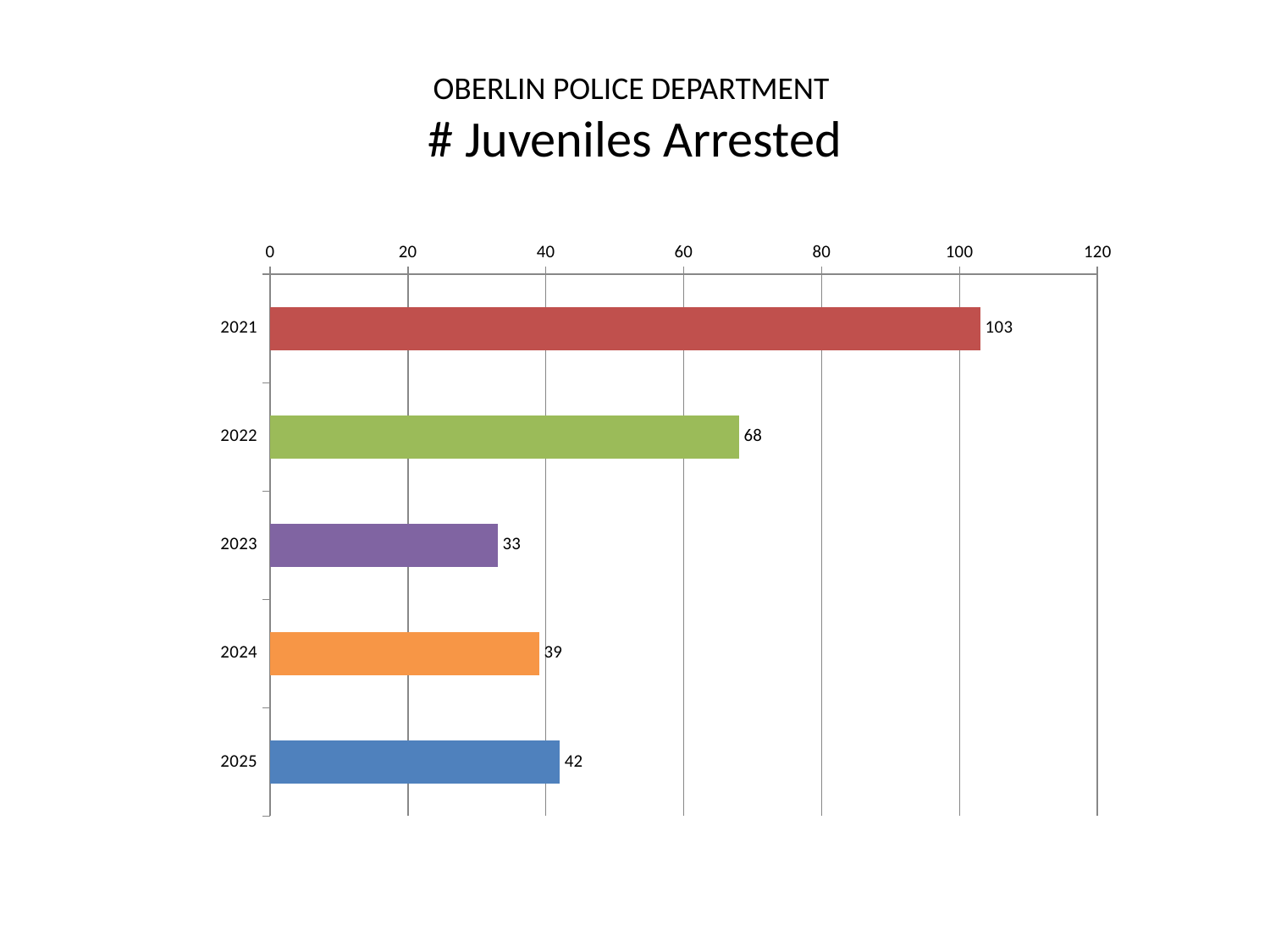
What is the difference between the values for 2021 and 2022? 35 What is the title of the chart? # Juveniles Arrested Is the value for 2022 greater or less than 60? greater What is the difference between the values for 2025 and 2024? 3 How many juveniles were arrested in 2021? 103 How many years are shown on the chart? 5 Which year has the lowest number of juveniles arrested? 2023 What is the value shown for 2025? 42 Which year has a larger value, 2022 or 2024? 2022 Which year has the highest number of juveniles arrested? 2021 What kind of chart is shown on the slide? Bar chart What is the value shown for 2023? 33